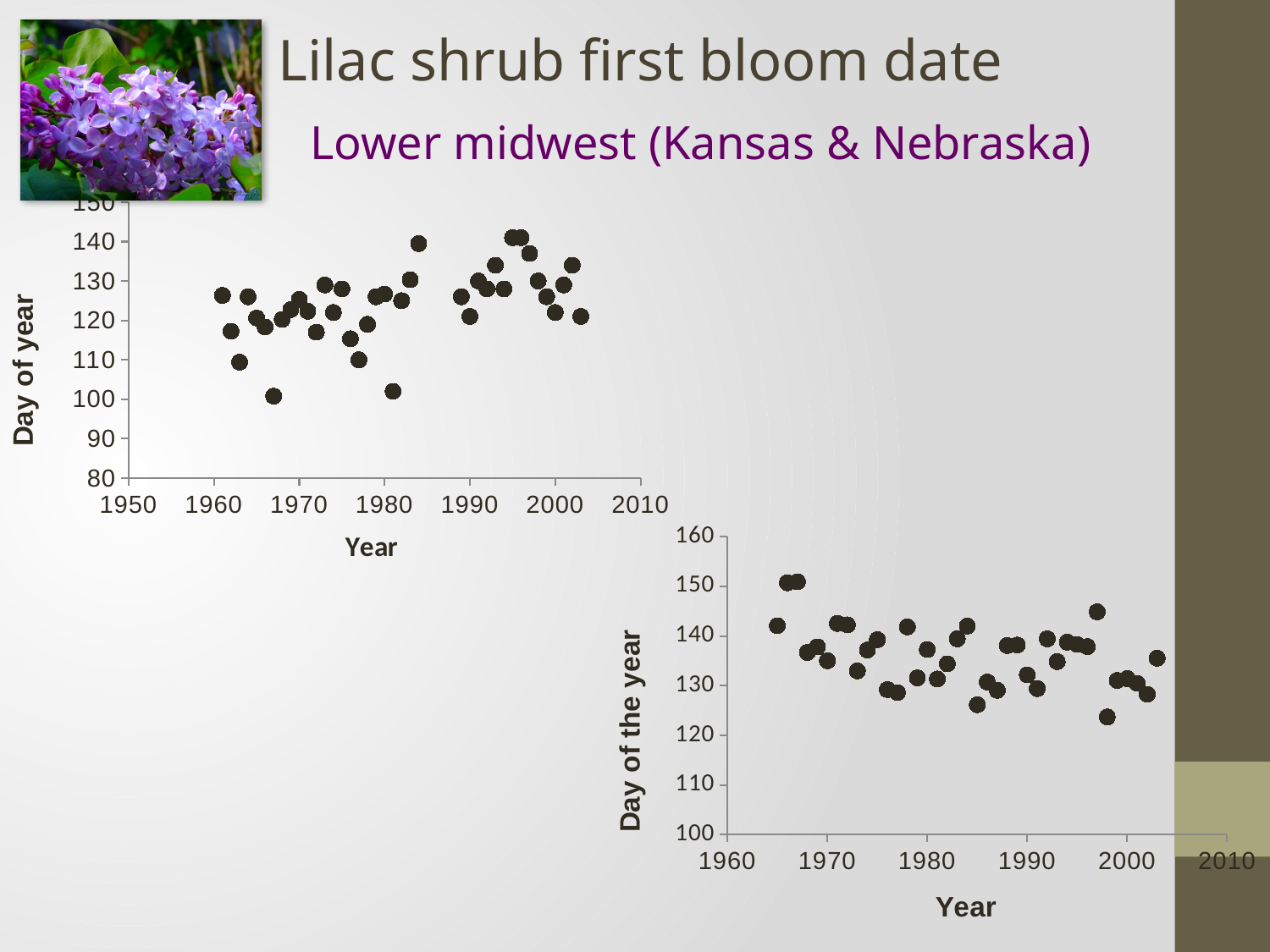
How many charts are shown on the slide? 2 In the top-left chart, is the value for the point near 1967 greater or less than 110? less In the top-left chart, what is the label of the vertical axis? Day of year In the bottom-right chart, around which year do the highest points occur? 1966–1967 In the bottom-right chart, is the point near 1966 higher or lower than the point near 1997? higher In the top-left chart, is the value for the point near 1984 greater or less than 130? greater In the bottom-right chart, are the values for the points near 1966 and 1967 greater or less than 140? greater What kind of chart is the bottom-right chart on the slide? Scatter chart What kind of chart is the top-left chart on the slide? Scatter chart In the top-left chart, is the point near 1967 higher or lower than the point near 1984? lower In the bottom-right chart, what is the label of the vertical axis? Day of the year